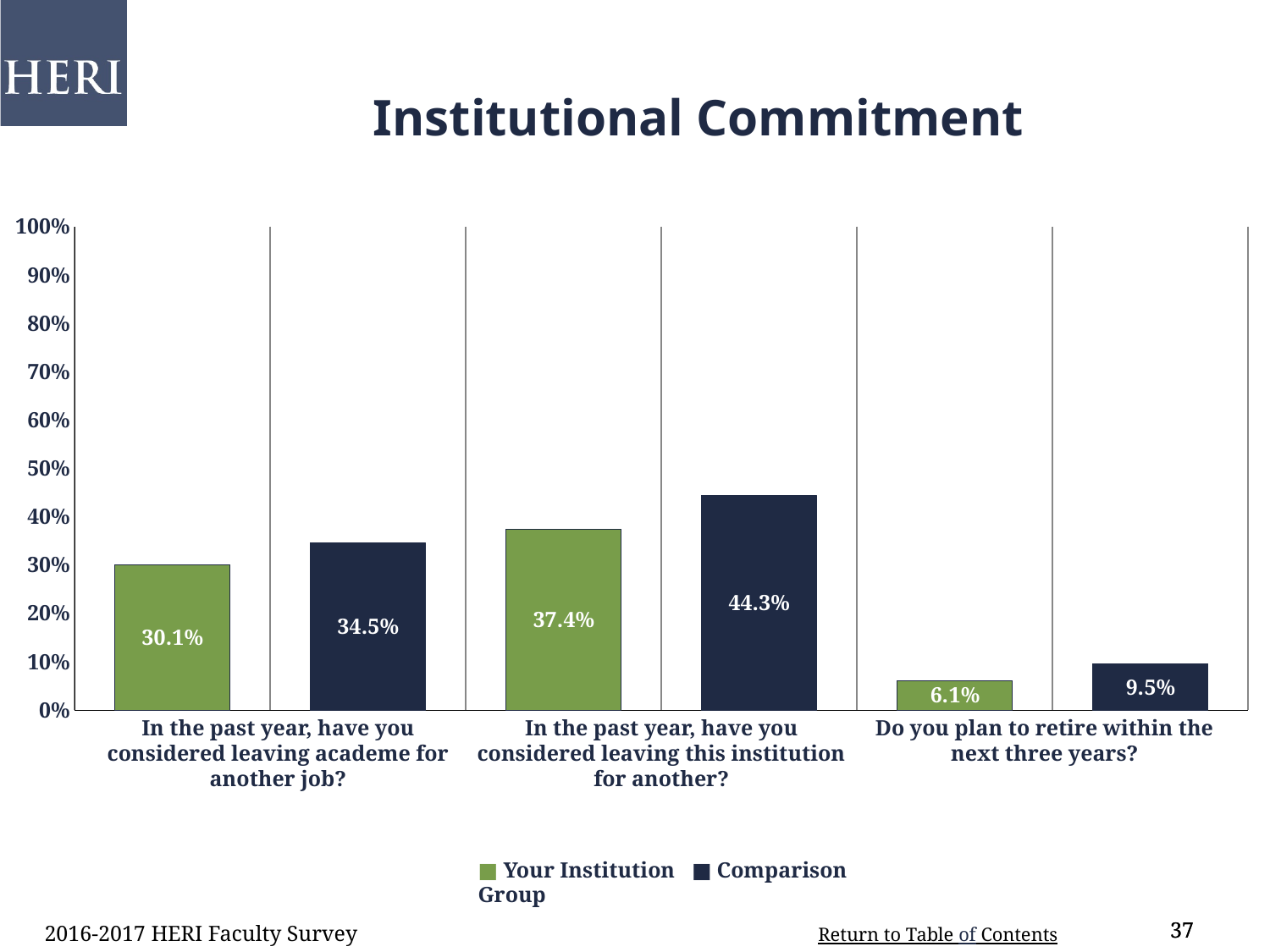
What kind of chart is shown on the slide? Bar chart Is the Comparison Group value for "In the past year, have you considered leaving academe for another job?" greater or less than 40%? less What is the value for Your Institution on "In the past year, have you considered leaving academe for another job?" 30.1% How many series does the legend list? 2 What is the value for Your Institution on "Do you plan to retire within the next three years?" 6.1% For "Do you plan to retire within the next three years?", which is larger: Your Institution or Comparison Group? Comparison Group What is the title of the chart? Institutional Commitment What is the value for Comparison Group on "In the past year, have you considered leaving this institution for another?" 44.3% Which question has the highest Comparison Group value? In the past year, have you considered leaving this institution for another? How many questions (categories) are shown on the x axis? 3 What is the difference between the Comparison Group and Your Institution values for "In the past year, have you considered leaving this institution for another?" 6.9% Which question has the lowest Your Institution value? Do you plan to retire within the next three years?